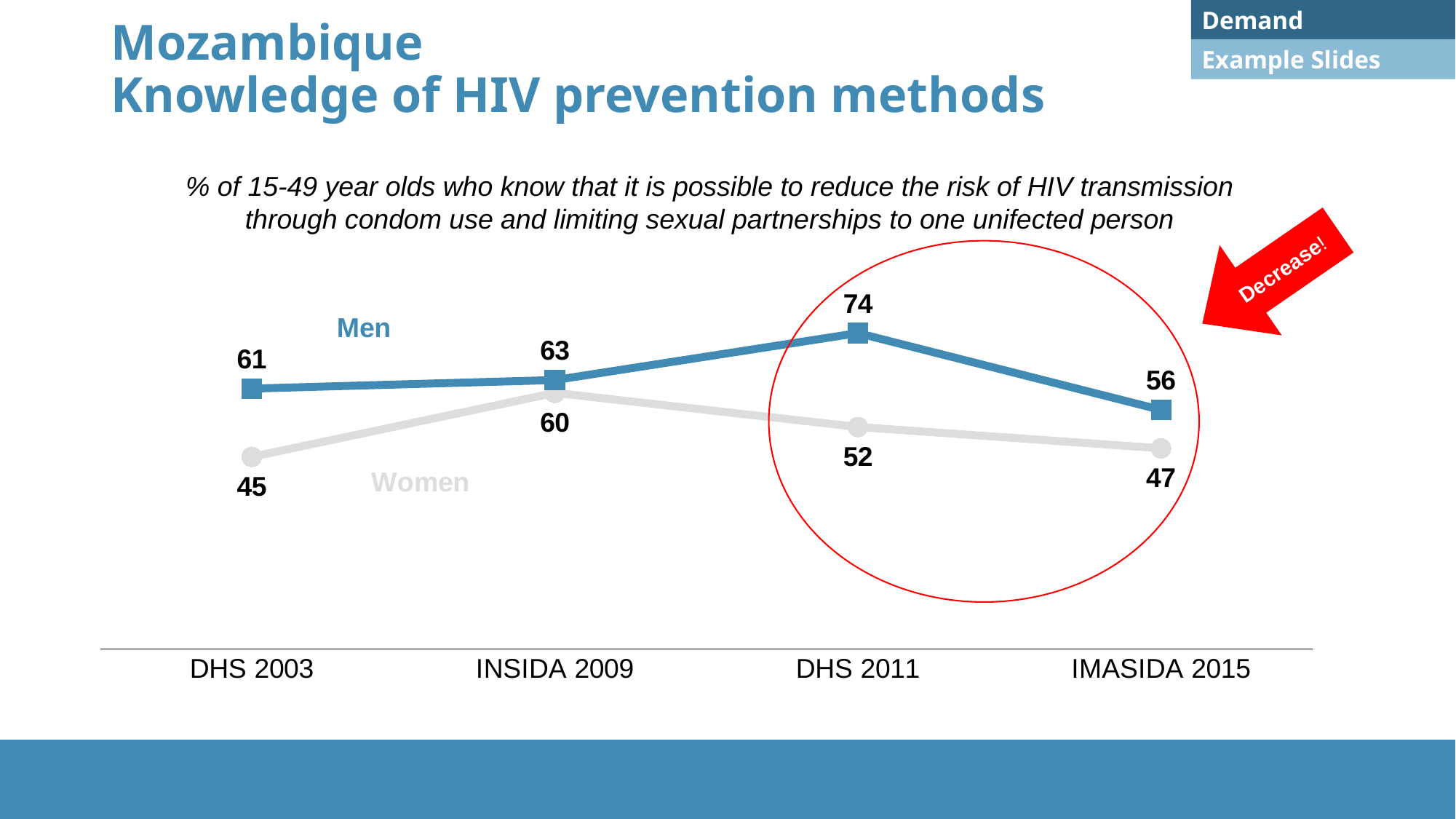
How many surveys are shown on the x axis? 4 What is the difference between the Men and Women values at DHS 2011? 22 Which is larger at INSIDA 2009, the value for Men or for Women? Men What is the value for Men at INSIDA 2009? 63 At which survey is the value for Women lowest? DHS 2003 Does the value for Men rise or fall from DHS 2011 to IMASIDA 2015? fall How many series are plotted on the chart? 2 What kind of chart is shown on the slide? line chart What is the value for Men at DHS 2011? 74 What is the value for Women at DHS 2003? 45 What is the value for Women at IMASIDA 2015? 47 At which survey is the value for Men highest? DHS 2011